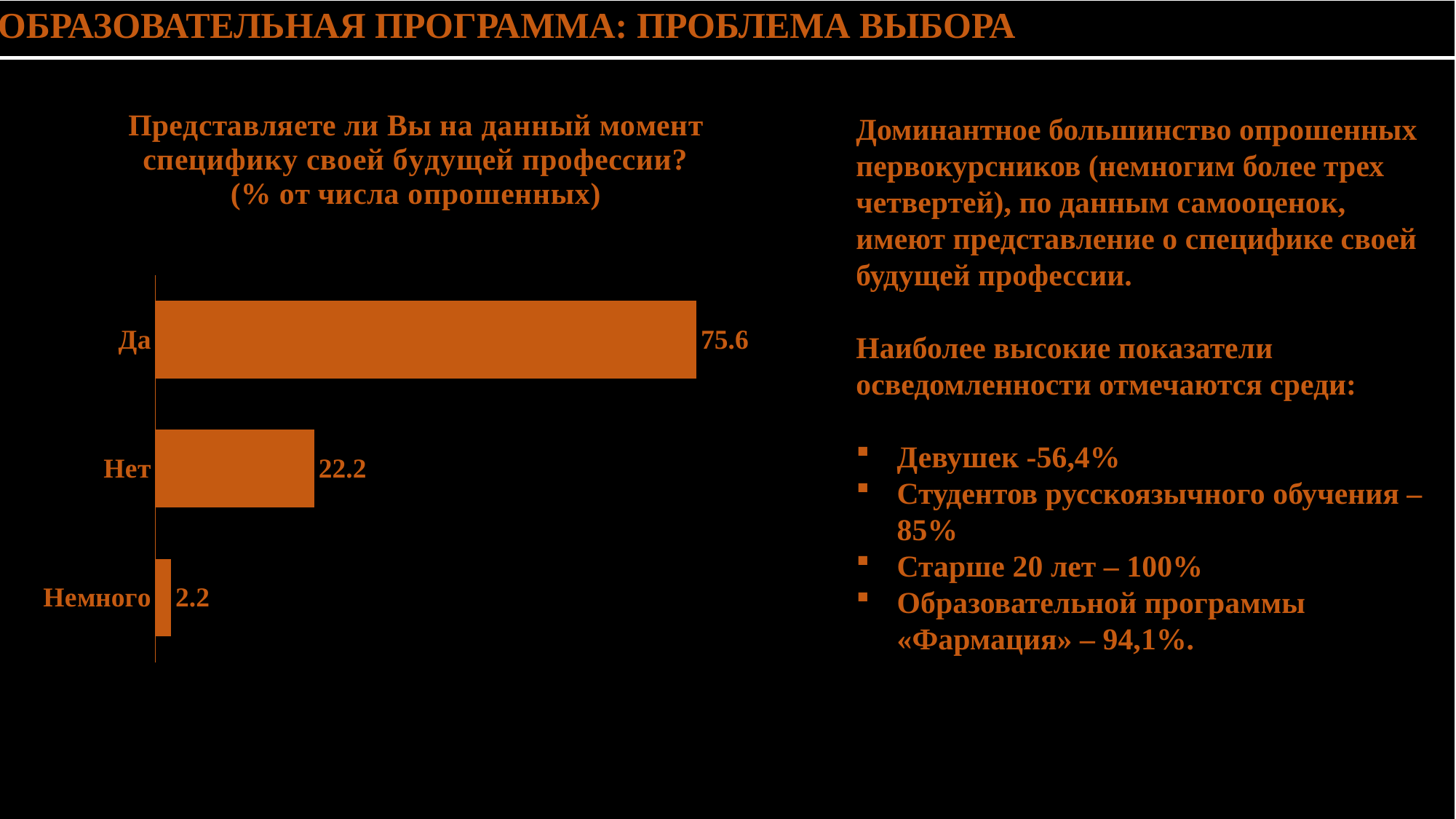
What value is shown for the category "Да"? 75.6 What is the difference between the values for "Нет" and "Немного"? 20 Which is larger, the value for "Нет" or the value for "Немного"? Нет What value is shown for the category "Нет"? 22.2 What is the total of the three values shown in the chart? 100 What value is shown for the category "Немного"? 2.2 What is the difference between the values for "Да" and "Нет"? 53.4 What kind of chart is shown on the slide? Bar chart Which category has the highest value? Да What colour are the bars in the chart? Orange How many categories are shown in the chart? 3 Which category has the lowest value? Немного